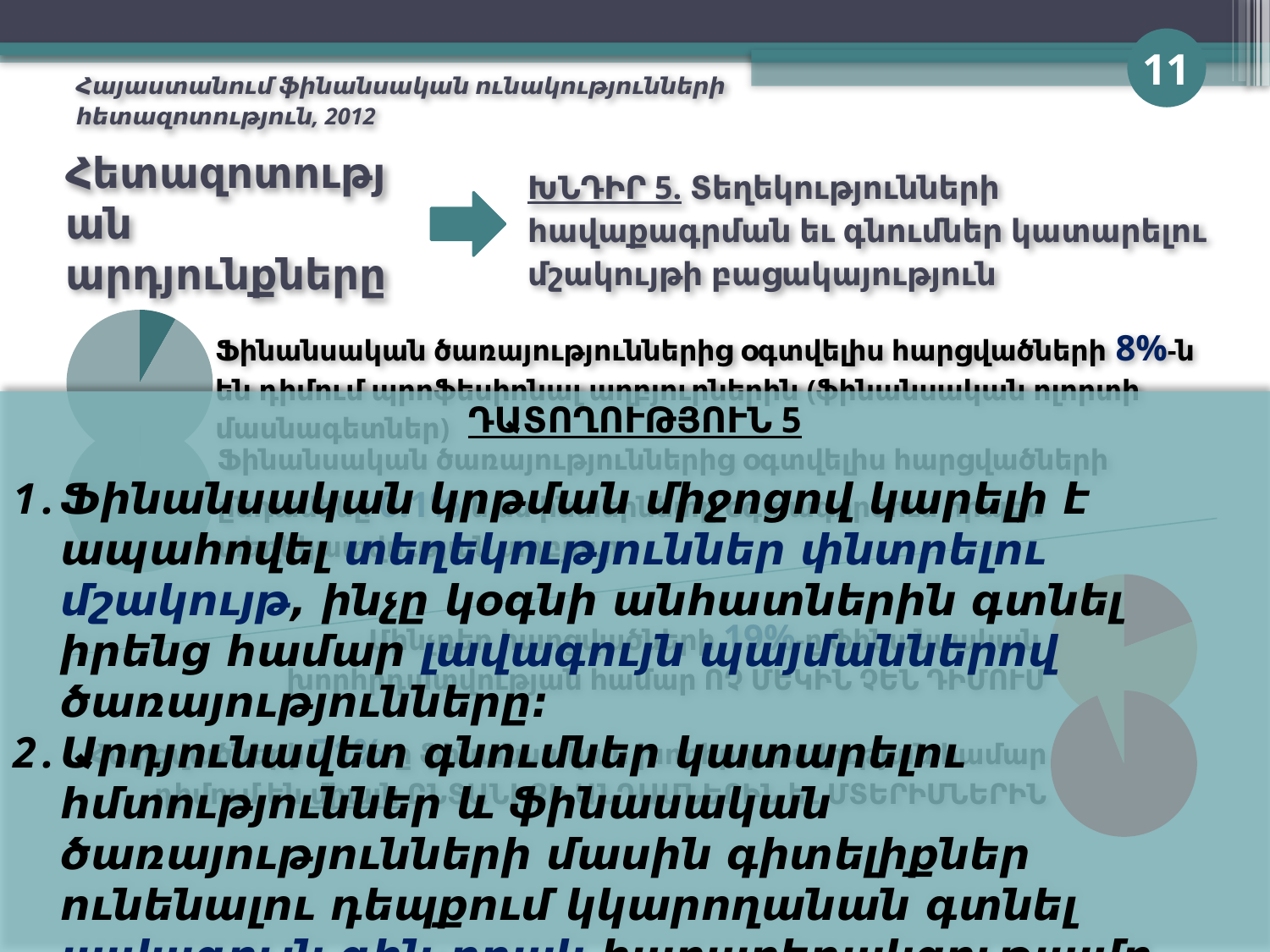
In the top-left pie chart, is the teal slice greater or less than half of the pie? less In the top-left pie chart, which slice is larger, the teal slice or the dark slice? the dark slice What kind of chart is shown at the top left of the slide, next to the text mentioning 8%? pie chart What kind of charts are partially visible on the right side of the slide? pie charts